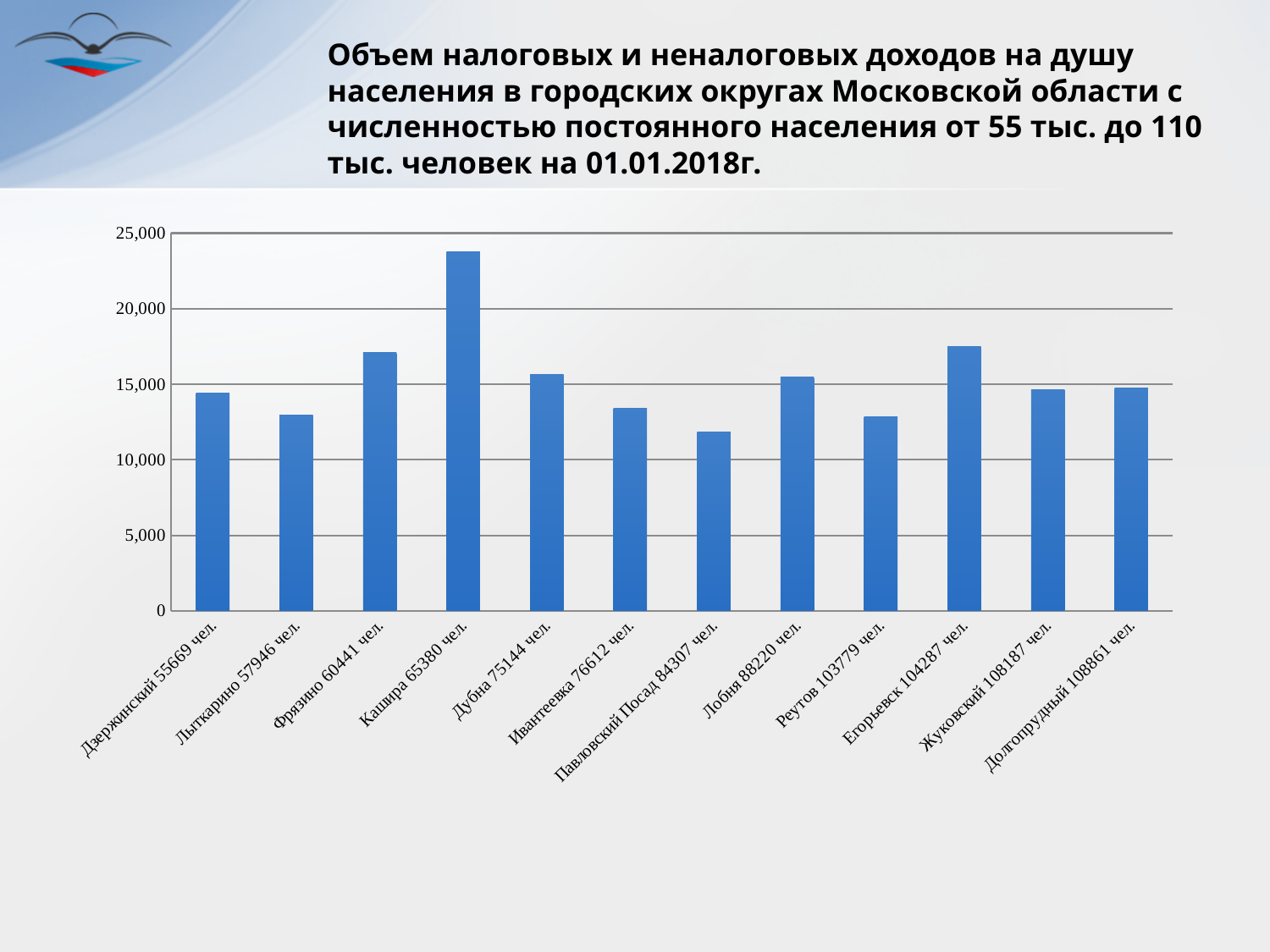
Is the value for Павловский Посад greater or less than 10,000? greater Which city district has the lowest value in the chart? Павловский Посад 84307 чел. Which has a larger value, Кашира or Фрязино? Кашира Which city district has the highest value in the chart? Кашира 65380 чел. Which has a larger value, Лыткарино or Дубна? Дубна What kind of chart is shown on the slide? bar chart Is the value for Фрязино greater or less than 15,000? greater Is the value for Реутов greater or less than 15,000? less What is the highest value shown on the vertical axis of the chart? 25,000 How many city districts (bars) are shown in the chart? 12